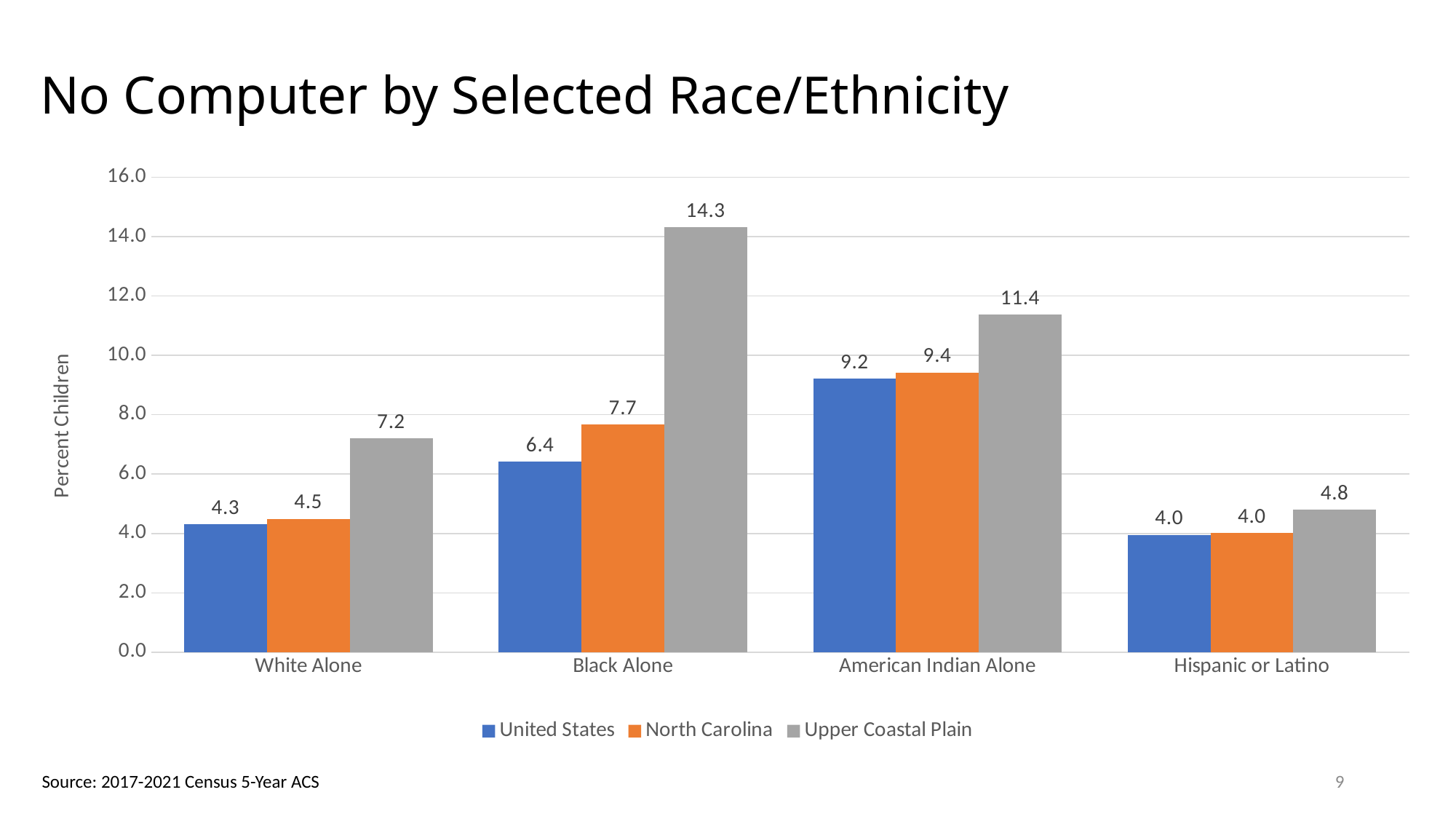
What is the value for United States in the American Indian Alone category? 9.2 Which category has the highest Upper Coastal Plain value? Black Alone What is the difference between the Upper Coastal Plain and United States values for Black Alone? 7.9 How many race/ethnicity categories are shown on the x axis? 4 What is the value for Upper Coastal Plain in the Black Alone category? 14.3 What is the value for North Carolina in the White Alone category? 4.5 Which category has the lowest United States value? Hispanic or Latino What is the title of the chart? No Computer by Selected Race/Ethnicity What is the label on the vertical axis? Percent Children Which is larger for American Indian Alone: the North Carolina value or the Upper Coastal Plain value? Upper Coastal Plain What kind of chart is shown on the slide? Bar chart How many series does the legend list? 3